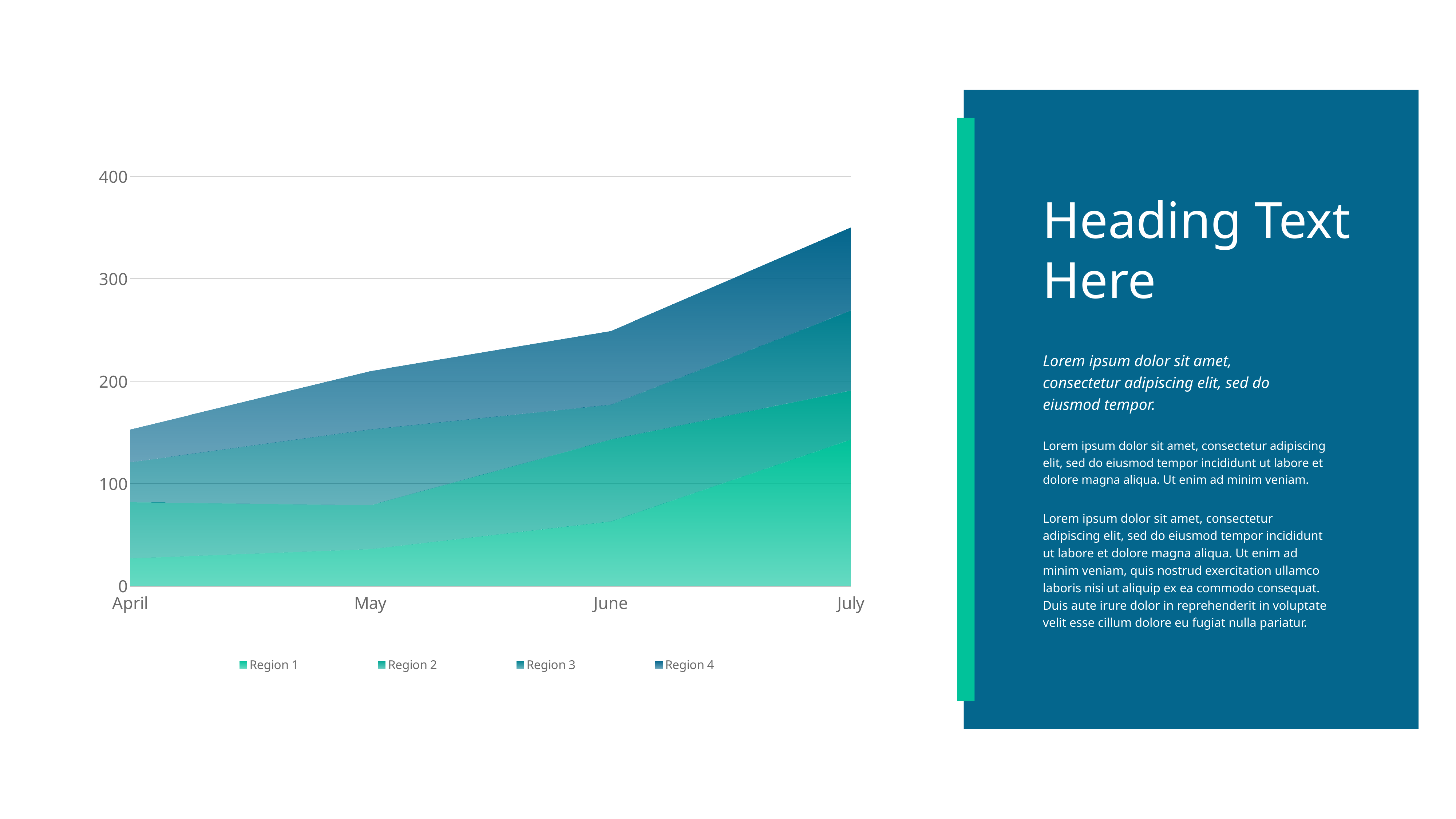
Is the value for Region 1 in July greater or less than 100? greater Which month has the highest stacked total? July Is the value for Region 1 in April greater or less than 100? less Which month has the lowest stacked total? April What is the name of the first series in the legend? Region 1 What kind of chart is shown on the slide? Area chart How many categories are shown on the x axis? 4 How many series does the legend list? 4 Is the stacked total for April greater or less than 200? less Do the stacked totals rise or fall from April to July? Rise